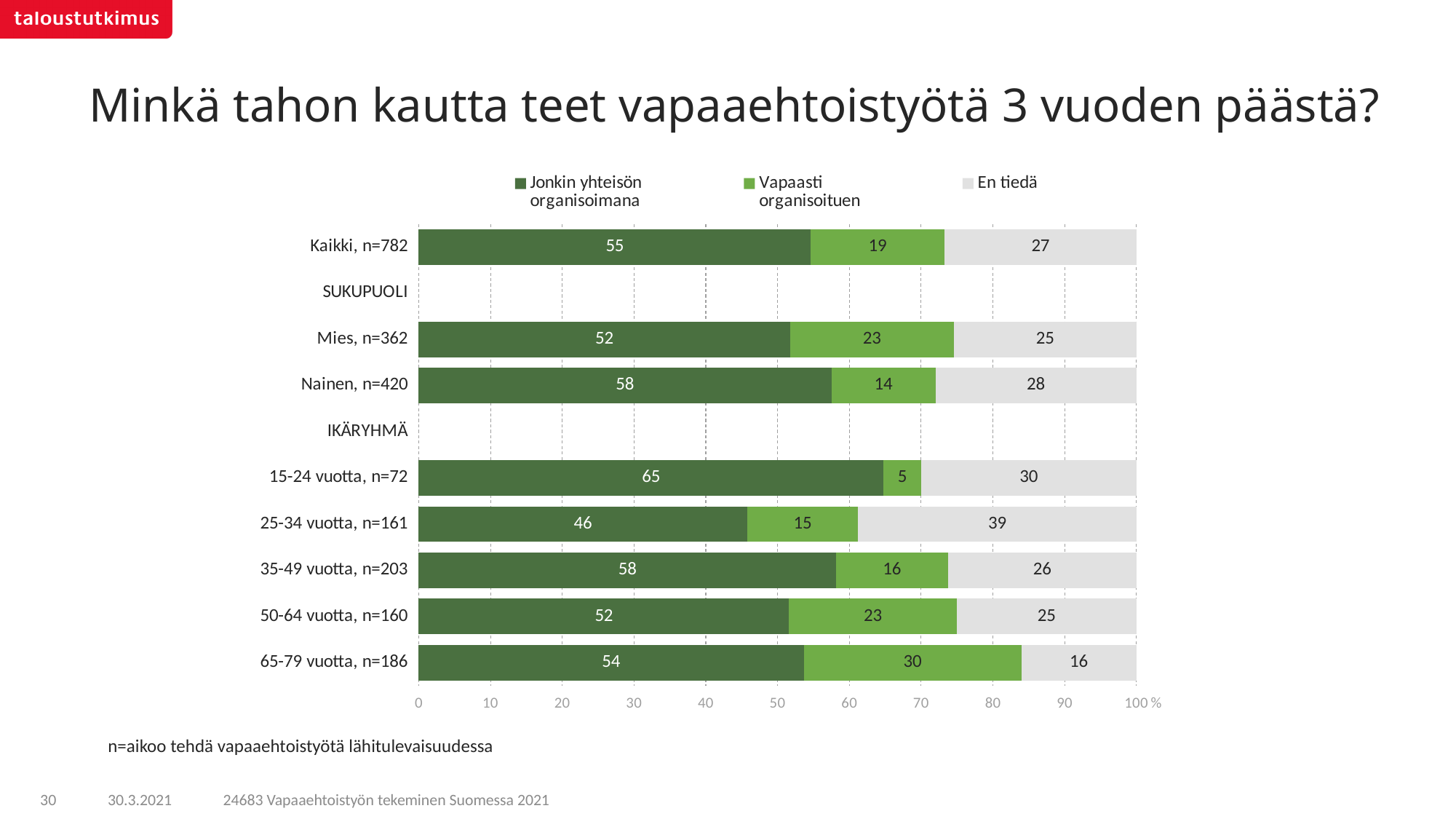
Which group has the highest value for "Jonkin yhteisön organisoimana"? 15-24 vuotta, n=72 What kind of chart is shown on the slide? Stacked bar chart How many age groups (IKÄRYHMÄ) are shown in the chart? 5 What is the value of "Vapaasti organisoituen" for 65-79 vuotta, n=186? 30 What is the difference between the "Jonkin yhteisön organisoimana" values for Nainen, n=420 and Mies, n=362? 6 What is the total of the stacked bar for 65-79 vuotta, n=186? 100 How many series does the legend list? 3 What is the value of "En tiedä" for 25-34 vuotta, n=161? 39 Which group has the lowest value for "Vapaasti organisoituen"? 15-24 vuotta, n=72 Which group has the lowest value for "En tiedä"? 65-79 vuotta, n=186 What is the value of "Jonkin yhteisön organisoimana" for Kaikki, n=782? 55 Which is larger: the "Vapaasti organisoituen" value for Mies, n=362 or for Nainen, n=420? Mies, n=362